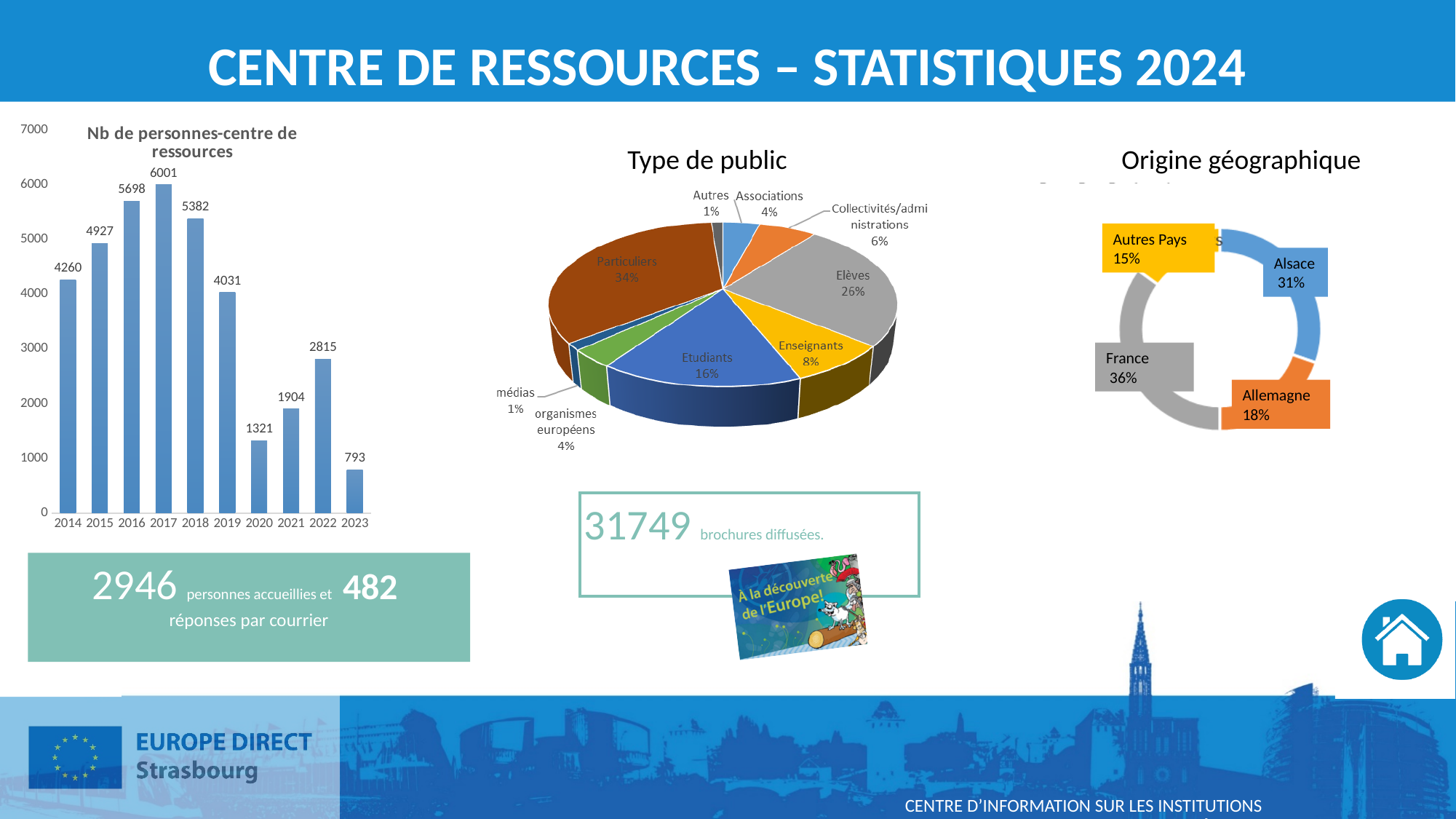
In the 'Type de public' pie chart, which category has the largest share? Particuliers In the chart 'Nb de personnes-centre de ressources', which year has the highest value? 2017 In the chart 'Nb de personnes-centre de ressources', what is the value for 2017? 6001 In the 'Origine géographique' chart, which category has the largest share? France In the 'Origine géographique' chart, what is the share for Allemagne? 18% In the chart 'Nb de personnes-centre de ressources', which year has the lowest value? 2023 What kind of chart is 'Nb de personnes-centre de ressources'? bar chart In the chart 'Nb de personnes-centre de ressources', do the values rise or fall from 2017 to 2020? fall In the chart 'Nb de personnes-centre de ressources', how many years are shown on the x axis? 10 In the chart 'Nb de personnes-centre de ressources', what is the difference between the values for 2022 and 2021? 911 In the 'Type de public' pie chart, what share do Elèves represent? 26% In the 'Type de public' pie chart, which is larger, Etudiants or Enseignants? Etudiants